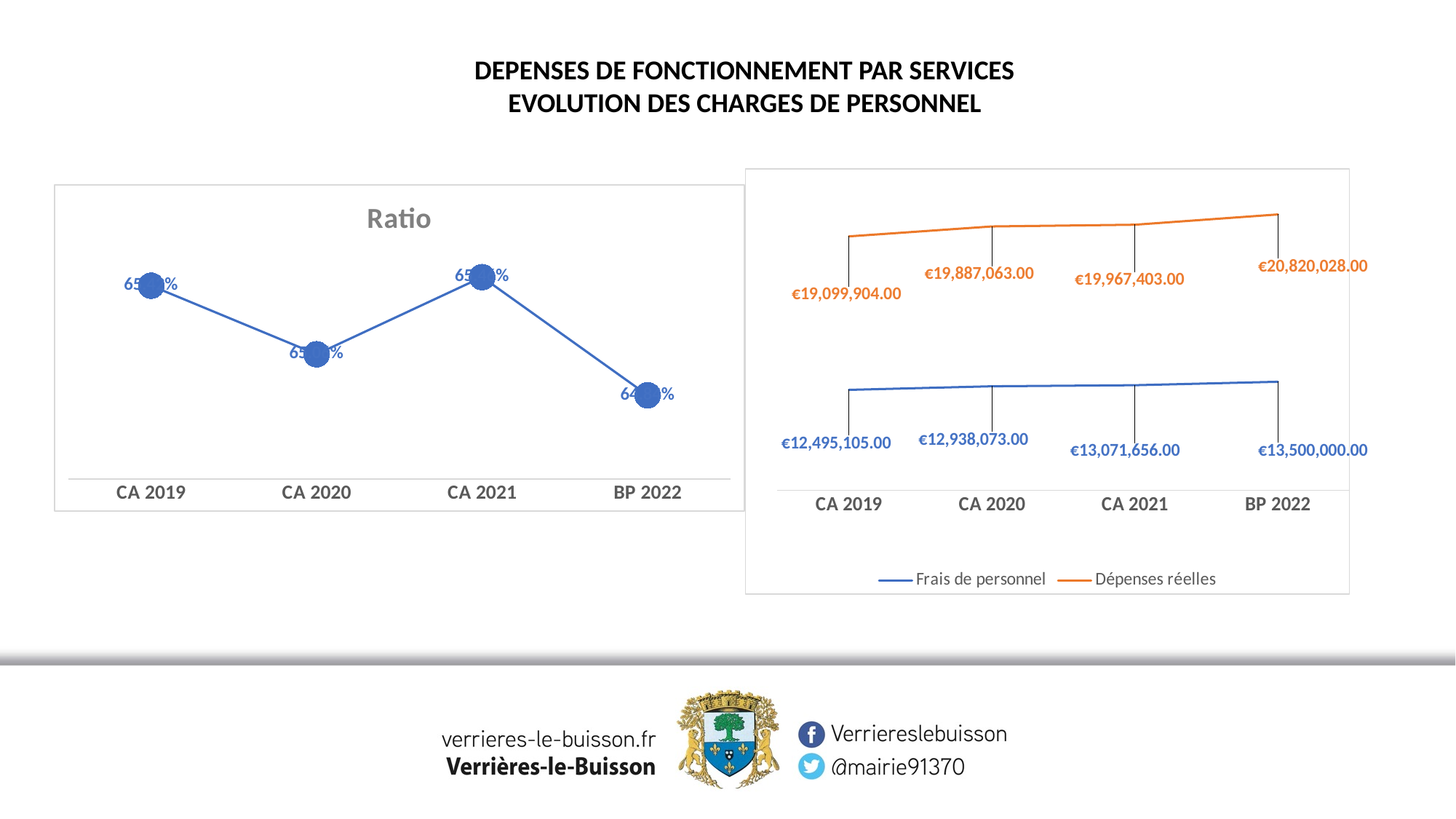
On the right chart, what is the difference between Dépenses réelles and Frais de personnel for CA 2019? €6,604,799.00 On the left chart titled Ratio, which period has the lowest value? BP 2022 On the right chart, in which period is Dépenses réelles highest? BP 2022 On the right chart, what is the value of Dépenses réelles for CA 2019? €19,099,904.00 On the right chart, what is the difference between Dépenses réelles for BP 2022 and for CA 2019? €1,720,124.00 On the right chart, do the Frais de personnel values rise or fall from CA 2019 to BP 2022? rise On the right chart, in which period is Frais de personnel lowest? CA 2019 On the right chart, what is the value of Frais de personnel for BP 2022? €13,500,000.00 On the right chart, what is the value of Dépenses réelles for CA 2021? €19,967,403.00 On the right chart, what is the value of Frais de personnel for CA 2020? €12,938,073.00 What kind of chart is the left chart titled Ratio? line chart How many series does the legend of the right chart list? 2